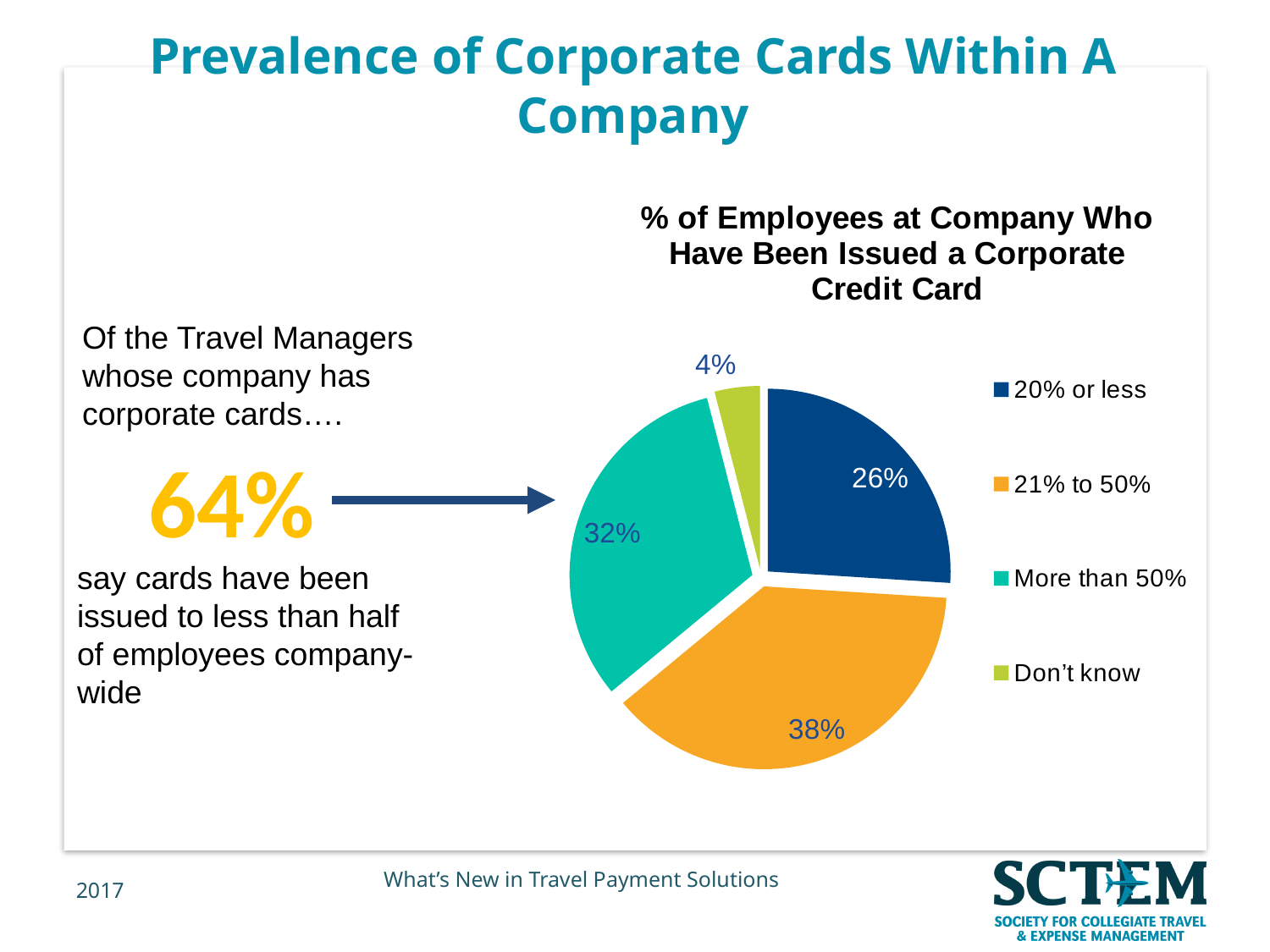
What is the difference in percentage points between the '21% to 50%' slice and the '20% or less' slice? 12 How many categories are shown in the pie chart? 4 Which category has the largest slice of the pie chart? 21% to 50% Which category has the smallest slice of the pie chart? Don't know What type of chart is shown on the slide? Pie chart What percentage of the pie chart is for 'More than 50%'? 32% What is the title of the pie chart? % of Employees at Company Who Have Been Issued a Corporate Credit Card What percentage of the pie chart is for 'Don't know'? 4% What percentage of the pie chart is for '20% or less'? 26% What colour is the 'Don't know' slice in the pie chart? Light green What percentage of the pie chart is for '21% to 50%'? 38% Which slice is larger: 'More than 50%' or '20% or less'? More than 50%